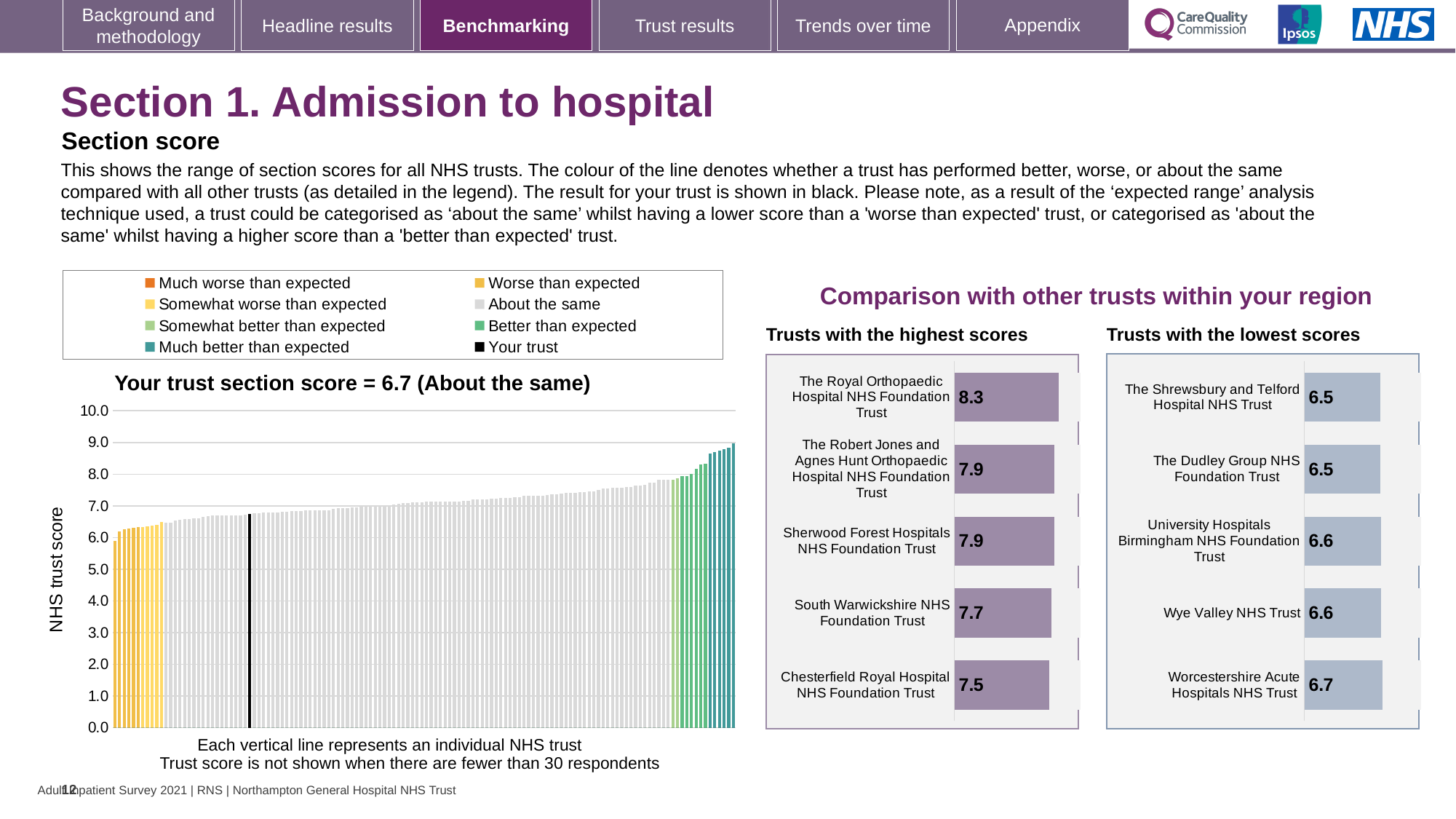
How many trusts are shown in the 'Trusts with the lowest scores' chart? 5 In the 'Your trust section score' chart, is the value of the shortest bar greater or less than 7.0? less In the 'Your trust section score' chart, what is the section score for your trust? 6.7 In the 'Trusts with the highest scores' chart, which trust has the highest score? The Royal Orthopaedic Hospital NHS Foundation Trust In the 'Trusts with the lowest scores' chart, which trust has the highest score? Worcestershire Acute Hospitals NHS Trust How many entries does the legend above the 'Your trust section score' chart list? 8 In the 'Trusts with the highest scores' chart, what is the score for Chesterfield Royal Hospital NHS Foundation Trust? 7.5 In the 'Your trust section score' chart, do the bars rise or fall from left to right? rise In the 'Trusts with the lowest scores' chart, what is the score for Wye Valley NHS Trust? 6.6 In the 'Trusts with the highest scores' chart, what is the difference between the scores of The Royal Orthopaedic Hospital NHS Foundation Trust and Chesterfield Royal Hospital NHS Foundation Trust? 0.8 What kind of chart is the 'Your trust section score' chart? bar chart In the 'Your trust section score' chart, is the value of the tallest bar greater or less than 8.0? greater